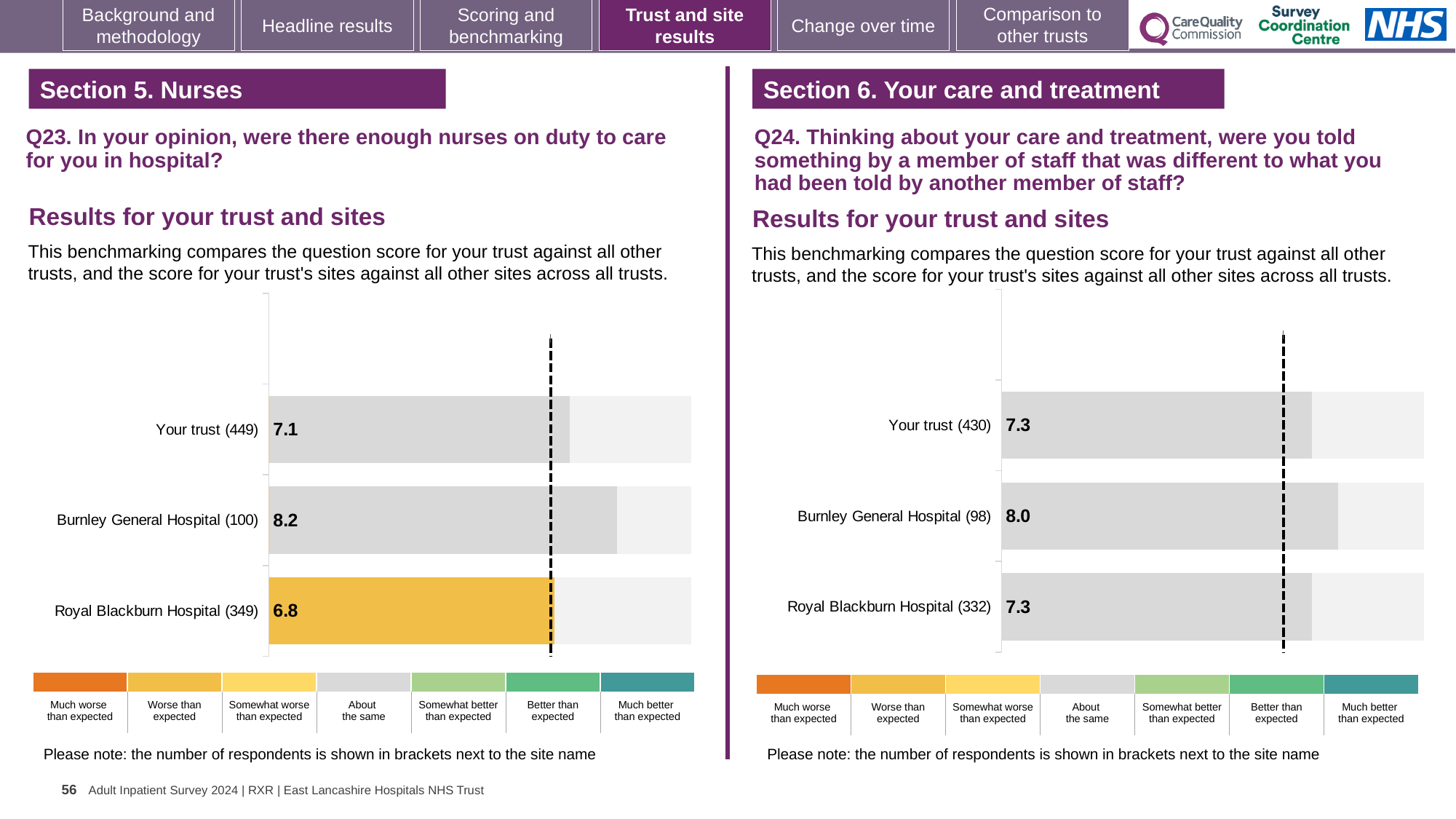
On the Q23 chart (enough nurses on duty), what is the difference between the scores for Burnley General Hospital and Royal Blackburn Hospital? 1.4 On the Q23 chart (enough nurses on duty), which site or trust has the lowest score? Royal Blackburn Hospital On the Q23 chart (enough nurses on duty), what is the score for Royal Blackburn Hospital? 6.8 On the Q24 chart (told something different by another member of staff), which site or trust has the highest score? Burnley General Hospital On the Q23 chart (enough nurses on duty), which bar is coloured yellow rather than grey? Royal Blackburn Hospital On the Q24 chart (told something different by another member of staff), what is the score for Burnley General Hospital? 8.0 On the Q23 chart (enough nurses on duty), what is the score for Burnley General Hospital? 8.2 On the Q23 chart (enough nurses on duty), what is the score for Your trust? 7.1 On the Q24 chart (told something different by another member of staff), how many respondents are shown in brackets for Royal Blackburn Hospital? 332 What kind of chart is used on the Q24 chart (told something different by another member of staff)? Bar chart On the Q24 chart (told something different by another member of staff), what is the score for Your trust? 7.3 On the Q23 chart (enough nurses on duty), which site or trust has the highest score? Burnley General Hospital